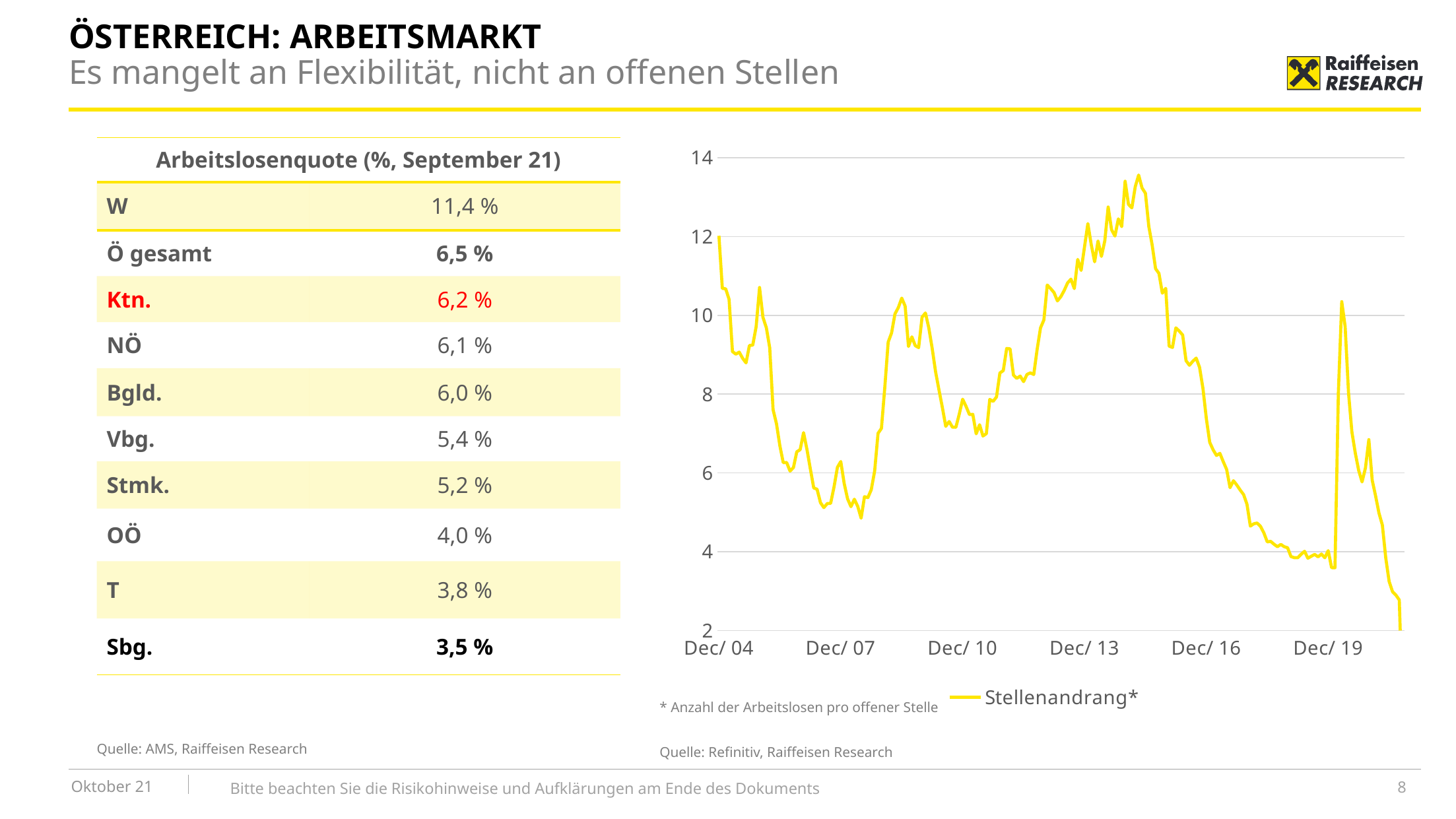
In the line chart, is the spike in Stellenandrang shortly after Dec/ 19 greater or less than 8? greater What kind of chart is shown on the right side of the slide? line chart How many series does the legend of the line chart list? 1 What is the name of the series plotted in the line chart? Stellenandrang* How many date labels are shown on the x-axis of the line chart? 6 In the line chart, is the value of Stellenandrang at the right end of the series (2021) greater or less than 4? less In the line chart, is the value of Stellenandrang at its peak around 2014/2015 greater or less than 12? greater In the line chart, does Stellenandrang rise or fall between its peak around 2015 and Dec/ 19? fall What is the highest value shown on the y-axis of the line chart? 14 In the line chart, is Stellenandrang higher at Dec/ 13 or at Dec/ 07? Dec/ 13